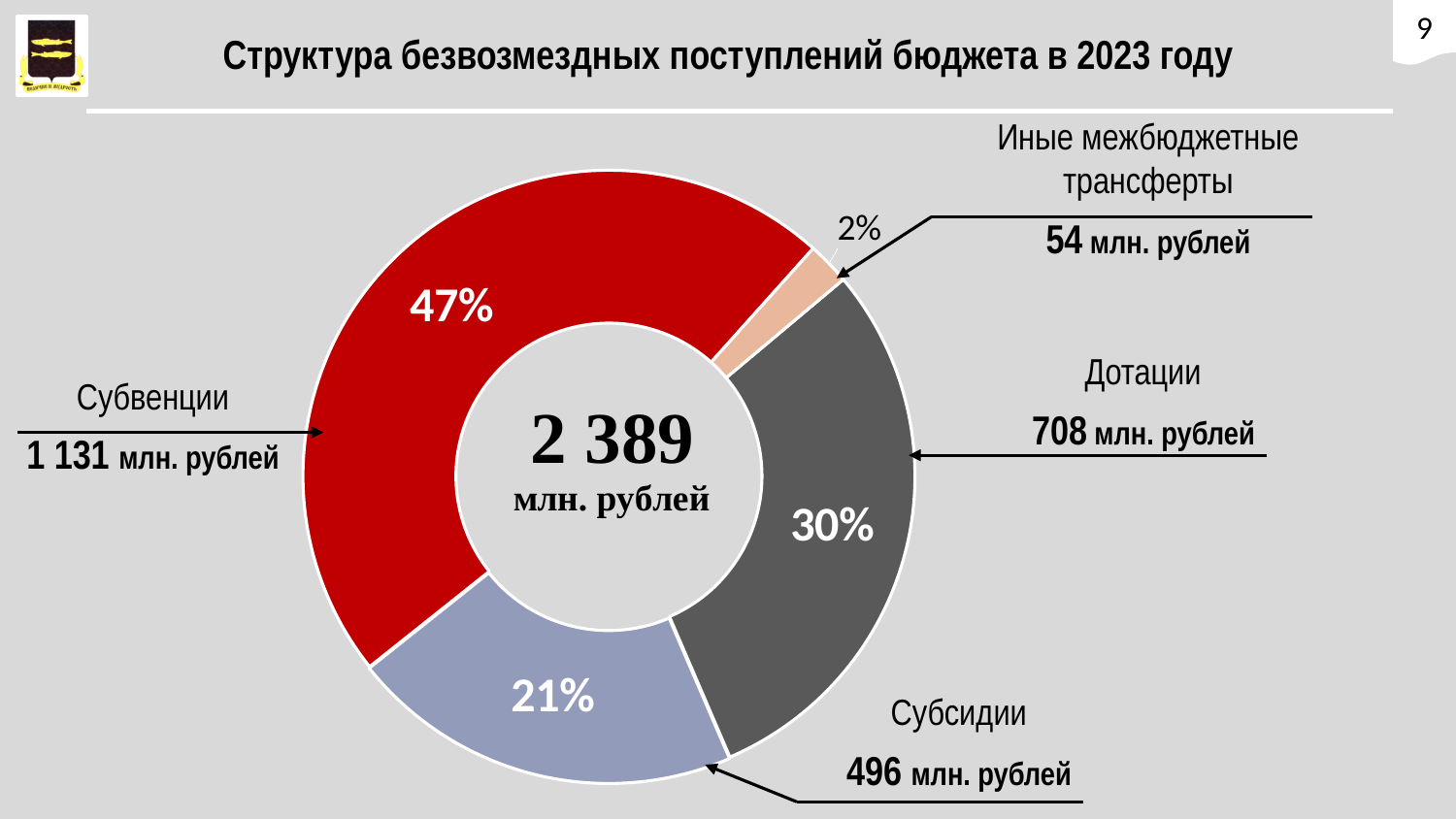
Which category has the smallest share of the chart? Иные межбюджетные трансферты What is the difference in value between Дотации and Субсидии? 212 млн. рублей What type of chart is shown on the slide? Pie (donut) chart What is the value for Субсидии? 496 млн. рублей What is the value for Иные межбюджетные трансферты? 54 млн. рублей Which category has the largest share of the chart? Субвенции What is the value for Дотации? 708 млн. рублей How many categories are shown in the chart? 4 Which is larger, the value for Субсидии or the value for Дотации? Дотации What share of the chart does Дотации account for? 30% What total is shown in the centre of the chart? 2 389 млн. рублей What share of the chart does Субвенции account for? 47%